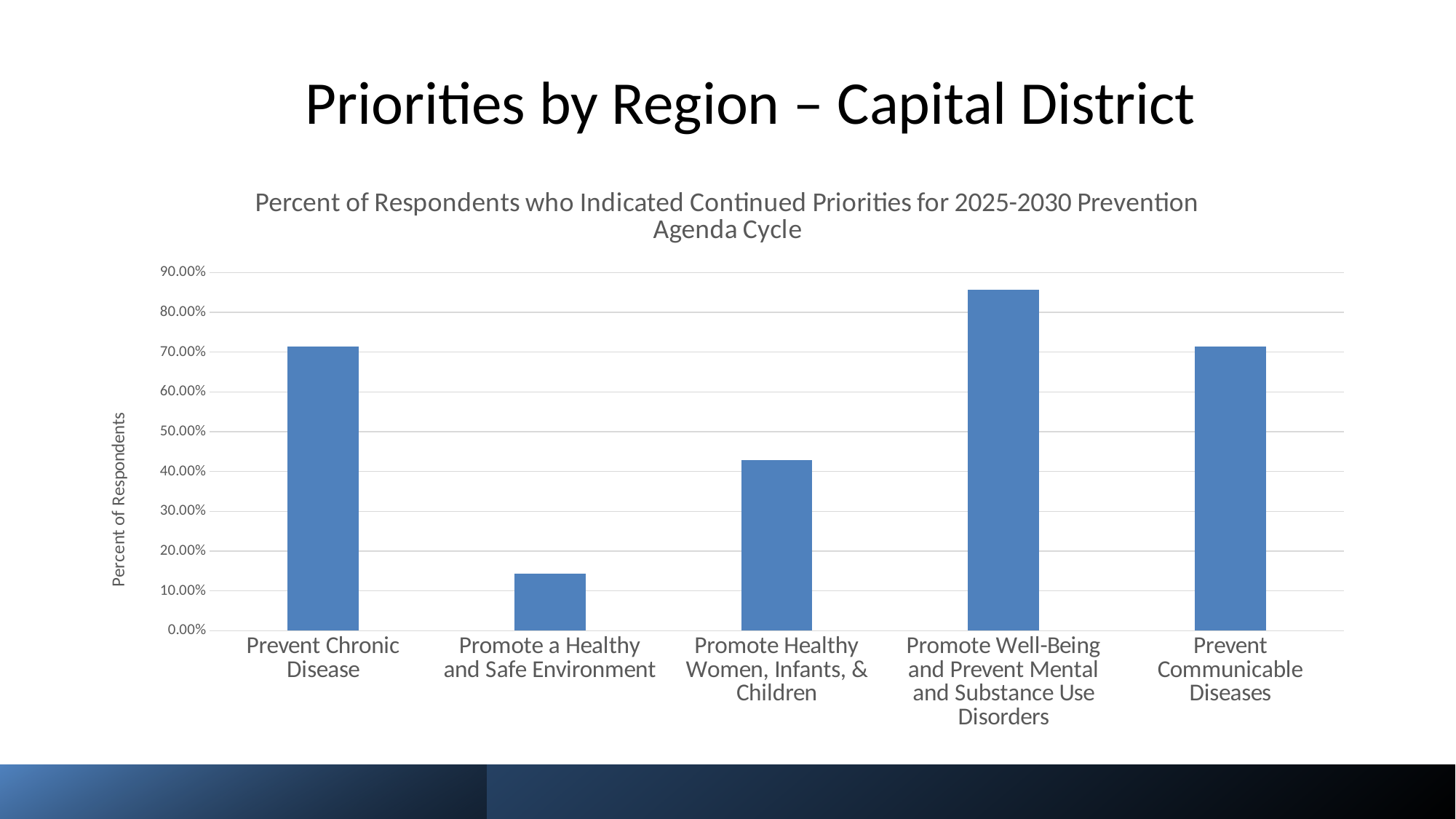
Which is larger, the value for Promote Healthy Women, Infants, & Children or the value for Prevent Communicable Diseases? Prevent Communicable Diseases What kind of chart is shown on the slide? bar chart How many categories are shown on the x axis of the chart? 5 Which category has the lowest percentage of respondents? Promote a Healthy and Safe Environment What is the label on the vertical axis of the chart? Percent of Respondents Which is larger, the value for Promote a Healthy and Safe Environment or the value for Promote Healthy Women, Infants, & Children? Promote Healthy Women, Infants, & Children Is the value for Prevent Communicable Diseases greater or less than 80.00%? less Is the value for Promote Healthy Women, Infants, & Children greater or less than 40.00%? greater Which category has the highest percentage of respondents? Promote Well-Being and Prevent Mental and Substance Use Disorders Is the value for Promote a Healthy and Safe Environment greater or less than 20.00%? less